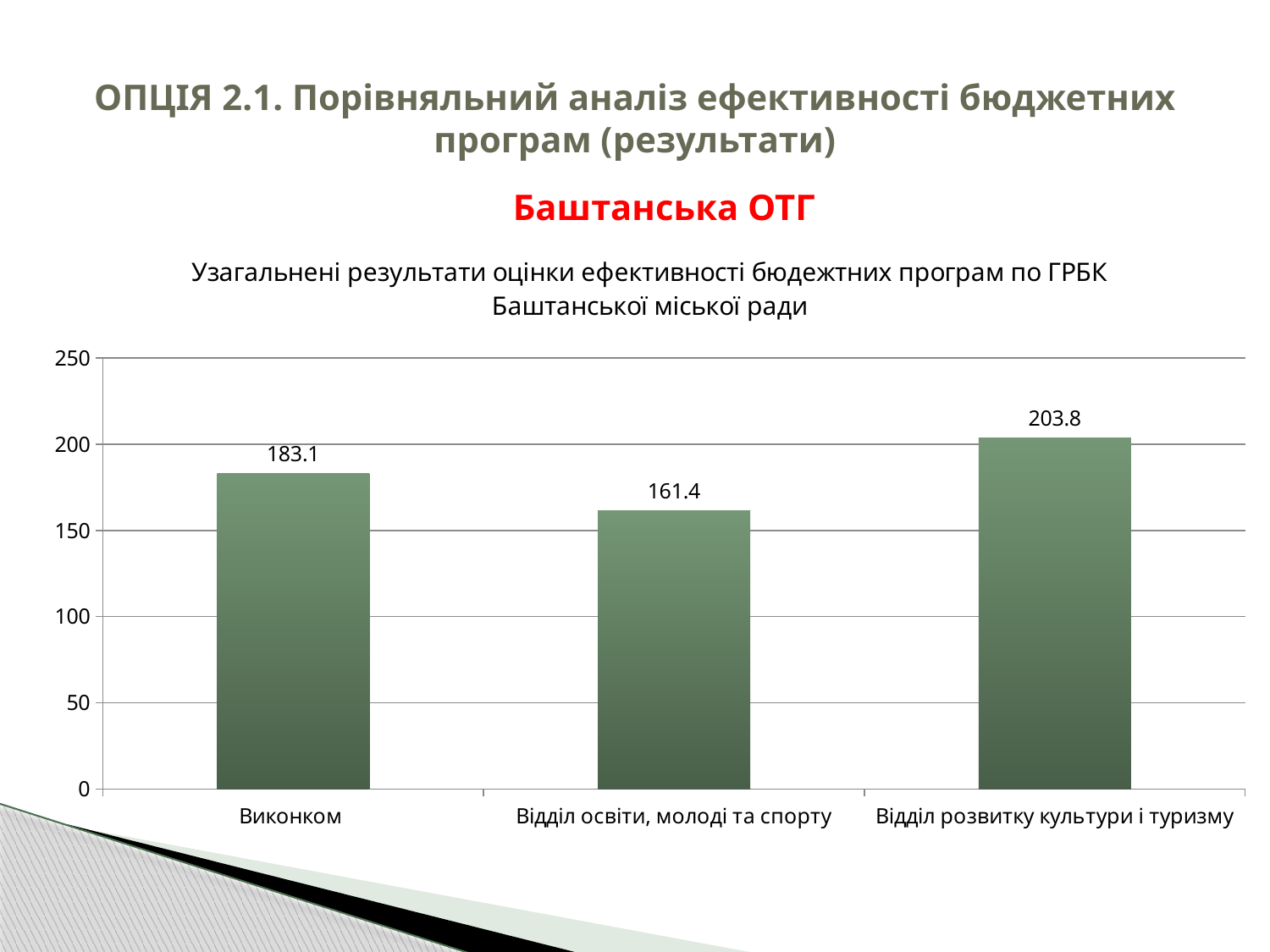
Which category has the highest value? Відділ розвитку культури і туризму What is the difference between the values for Відділ розвитку культури і туризму and Виконком? 20.7 How many categories are shown on the chart? 3 Which is larger, the value for Виконком or the value for Відділ освіти, молоді та спорту? Виконком Which category has the lowest value? Відділ освіти, молоді та спорту What is the difference between the values for Виконком and Відділ освіти, молоді та спорту? 21.7 What is the value for Відділ освіти, молоді та спорту? 161.4 What is the value for Виконком? 183.1 Is the value for Відділ розвитку культури і туризму greater or less than 200? greater What is the title of the chart? Узагальнені результати оцінки ефективності бюдежтних програм по ГРБК Баштанської міської ради What kind of chart is shown on the slide? bar chart What is the value for Відділ розвитку культури і туризму? 203.8